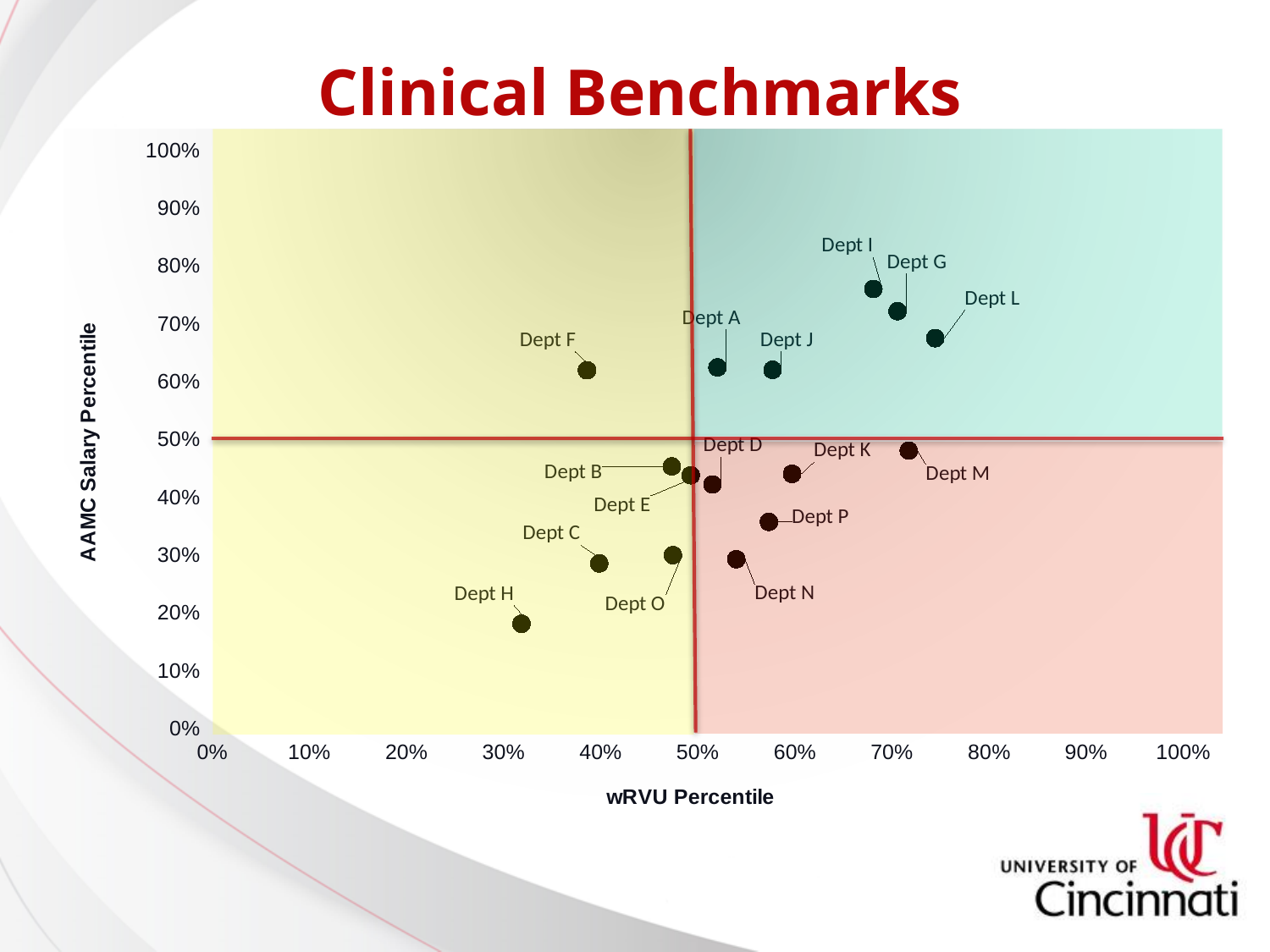
Which department has the lowest wRVU Percentile? Dept H Is the AAMC Salary Percentile for Dept H greater or less than 30%? less Is the AAMC Salary Percentile for Dept I greater or less than 70%? greater How many departments are plotted on the chart? 16 Which department has the highest wRVU Percentile? Dept L What is the title of the horizontal axis? wRVU Percentile Is the wRVU Percentile for Dept F greater or less than 50%? less What kind of chart is shown on the slide? Scatter chart What is the title of the vertical axis? AAMC Salary Percentile Which has the higher wRVU Percentile, Dept L or Dept F? Dept L Which department has the highest AAMC Salary Percentile? Dept I Which department has the lowest AAMC Salary Percentile? Dept H